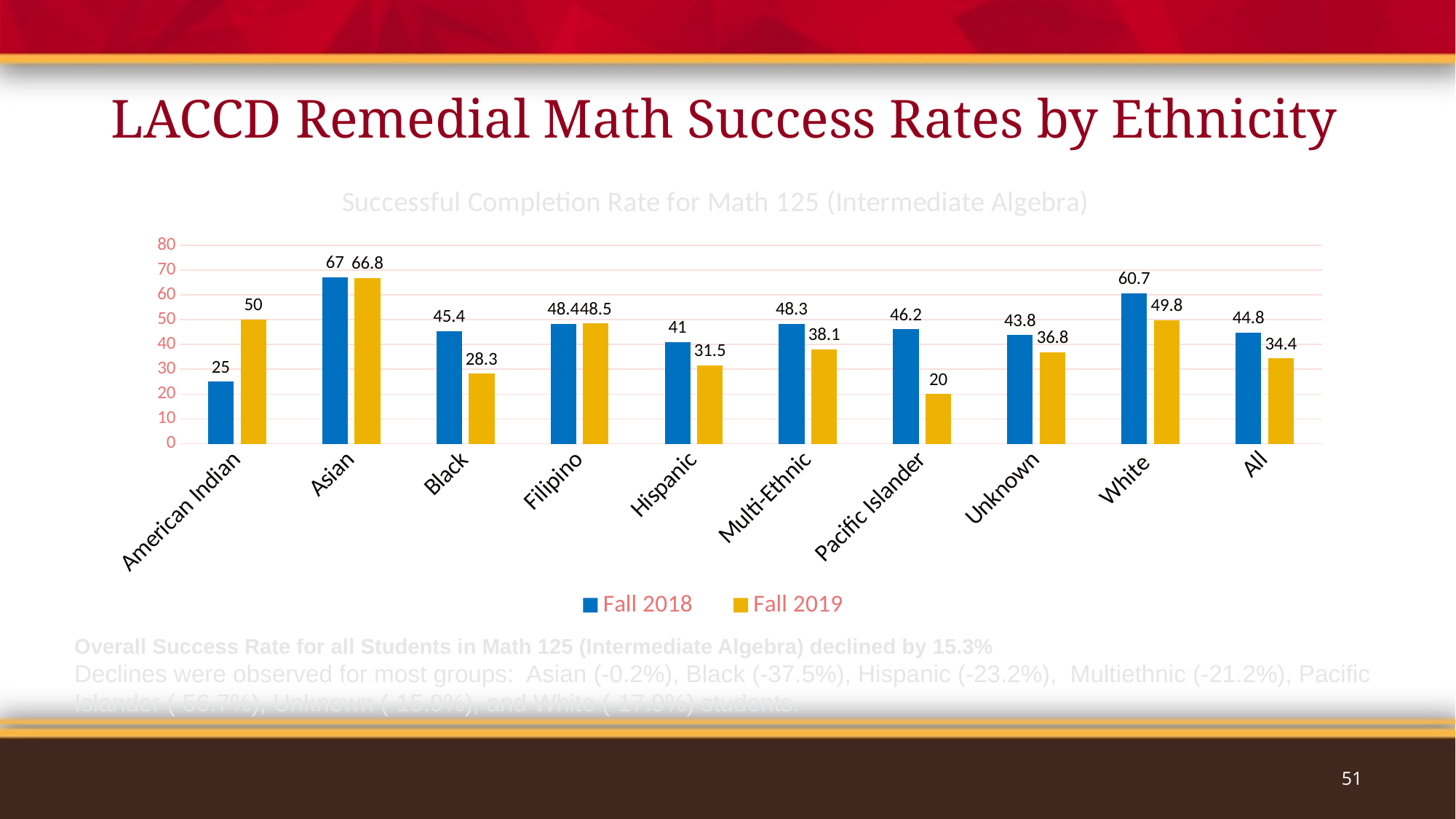
What is the difference between the Fall 2019 and Fall 2018 values for American Indian? 25 How many series does the legend list? 2 Which category has the highest Fall 2018 value? Asian Which is larger for Unknown, the Fall 2018 value or the Fall 2019 value? Fall 2018 What is the difference between the Fall 2018 and Fall 2019 values for Hispanic? 9.5 What is the title of the chart? Successful Completion Rate for Math 125 (Intermediate Algebra) What is the Fall 2019 value for Pacific Islander? 20 How many categories are shown on the x axis? 10 Which category has the lowest Fall 2019 value? Pacific Islander What kind of chart is shown on the slide? Bar chart What is the Fall 2018 value for Black? 45.4 What is the Fall 2019 value for White? 49.8